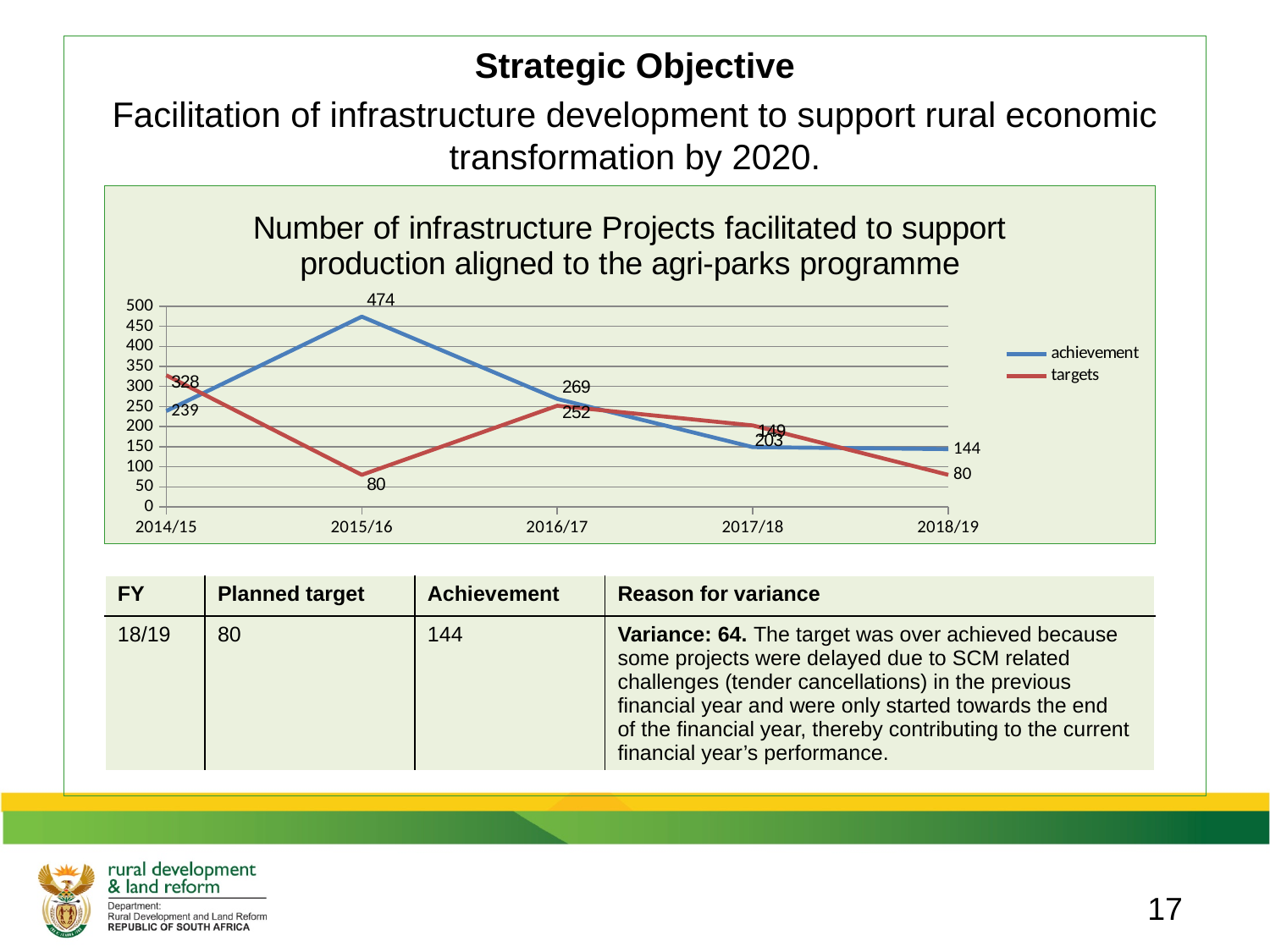
How many series does the legend list? 2 By how much does achievement exceed targets in 2018/19? 64 What is the targets value for 2018/19? 80 What is the achievement value for 2018/19? 144 How many financial years are shown on the x axis? 5 What kind of chart is shown on the slide? line chart In 2014/15, which is larger: achievement or targets? targets In which financial year is the achievement series highest? 2015/16 What is the difference between achievement and targets in 2015/16? 394 What is the targets value for 2014/15? 328 What is the achievement value for 2015/16? 474 In which financial year is the targets series highest? 2014/15